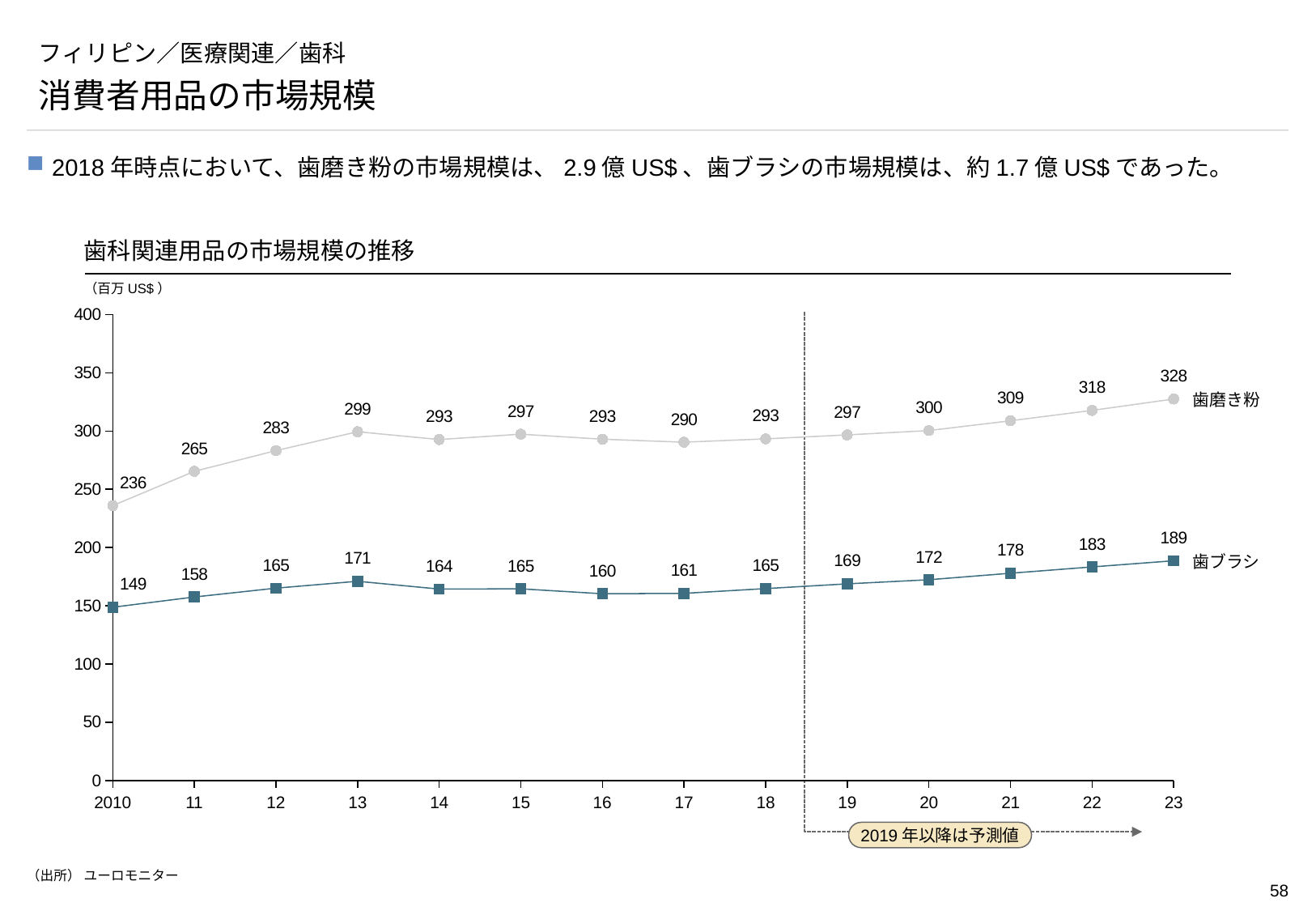
How many years are shown on the x axis? 14 What is the forecast value for 歯磨き粉 in 23? 328 Does the value for 歯ブラシ rise or fall from 19 to 23? rise In which year is the value for 歯磨き粉 lowest? 2010 How many series are plotted in the chart? 2 Is the value for 歯ブラシ in 2010 greater or less than 200? less Which is larger in 13: 歯磨き粉 or 歯ブラシ? 歯磨き粉 What is the difference between 歯磨き粉 and 歯ブラシ in 2018? 128 In which year does 歯ブラシ reach its highest value? 23 What is the value for 歯磨き粉 in 2018? 293 What kind of chart is shown? line chart What is the value for 歯ブラシ in 2010? 149